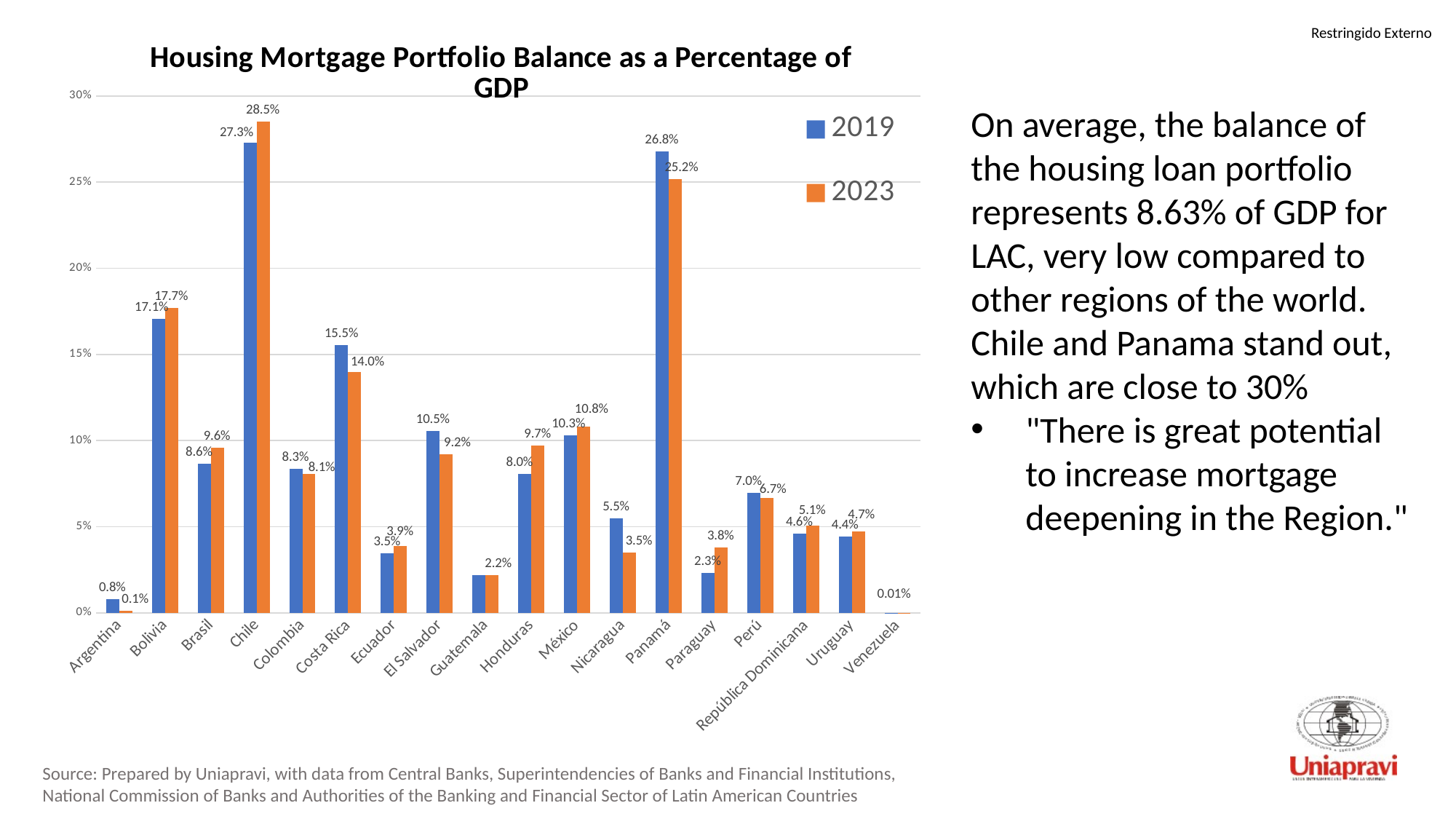
What is the 2019 value for Panamá? 26.8% What kind of chart is shown on the slide? Bar chart Which country has the highest 2023 value? Chile How many countries are shown on the x axis? 18 What is the 2023 value for Chile? 28.5% How many series does the legend list? 2 Is the 2019 value for Chile greater or less than 25%? greater For Bolivia, which year has the larger value, 2019 or 2023? 2023 What is the difference between the 2019 and 2023 values for Costa Rica? 1.5% Which country has the lowest values in the chart? Venezuela What is the 2023 value for Honduras? 9.7% What is the difference between the 2019 and 2023 values for Nicaragua? 2.0%